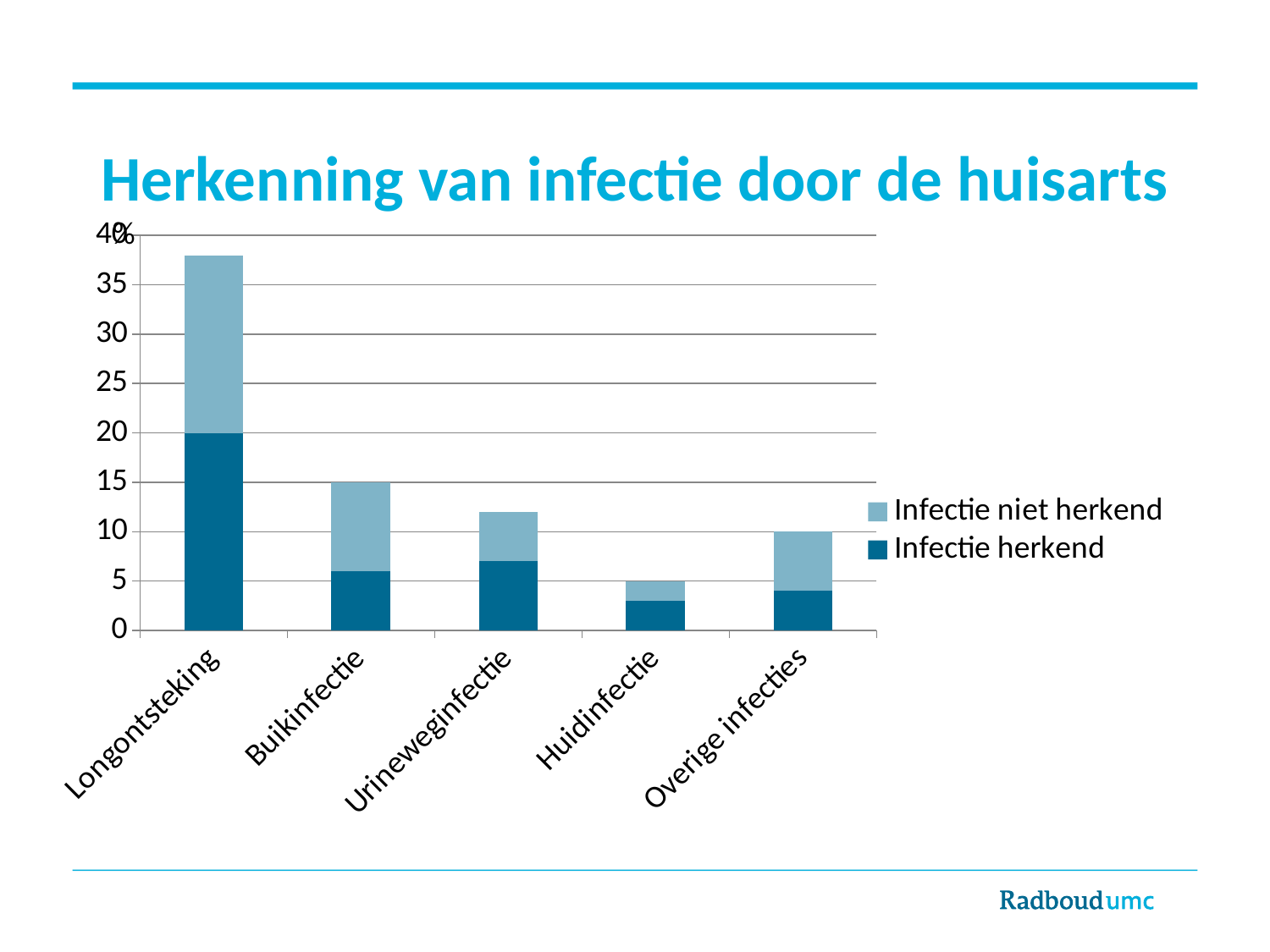
How many series does the legend list? 2 What is the total height of the stacked bar for Overige infecties? 10 What is the total height of the stacked bar for Buikinfectie? 15 How many infection categories are shown on the x axis? 5 Is the total bar for Longontsteking greater or less than 35? greater Which category has the lowest total bar? Huidinfectie Which category has the highest total bar? Longontsteking What kind of chart is shown on the slide? Stacked bar chart Is the 'Infectie herkend' value for Huidinfectie greater or less than 5? less What is the value of 'Infectie herkend' for Longontsteking? 20 What is the total height of the stacked bar for Huidinfectie? 5 Which has the larger total bar, Buikinfectie or Urineweginfectie? Buikinfectie